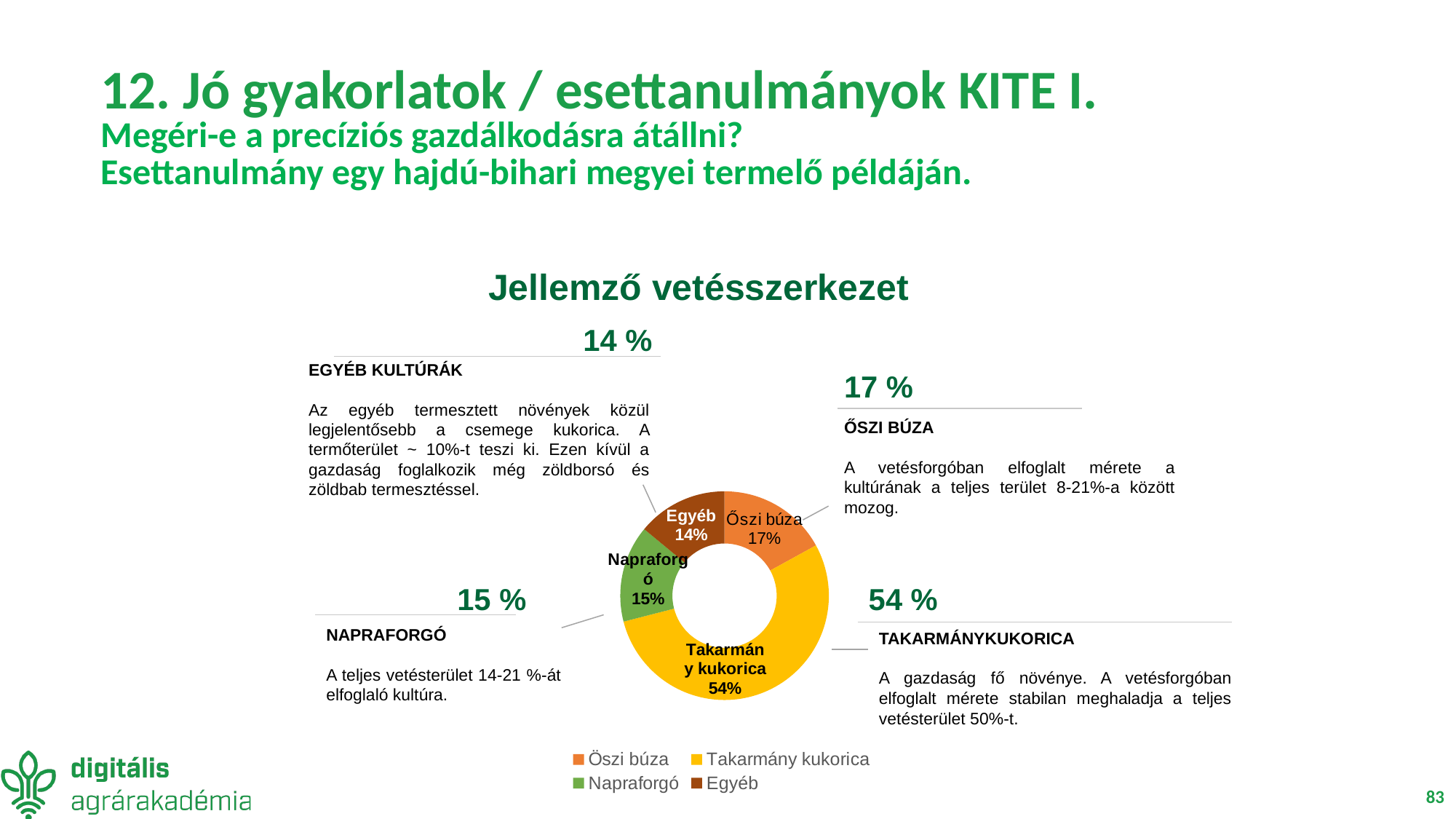
How many categories are shown in the chart? 4 Which is larger, the share for Őszi búza or the share for Napraforgó? Őszi búza What type of chart is shown under the title "Jellemző vetésszerkezet"? Doughnut chart What percentage is shown for Egyéb? 14% What is the title of the chart? Jellemző vetésszerkezet What share of the chart does Takarmány kukorica represent? 54% What is the difference in percentage points between Takarmány kukorica and Őszi búza? 37 Which category has the largest share of the chart? Takarmány kukorica What percentage is shown for Napraforgó? 15% How many entries does the legend list? 4 Which category has the smallest share of the chart? Egyéb What percentage is shown for Őszi búza? 17%